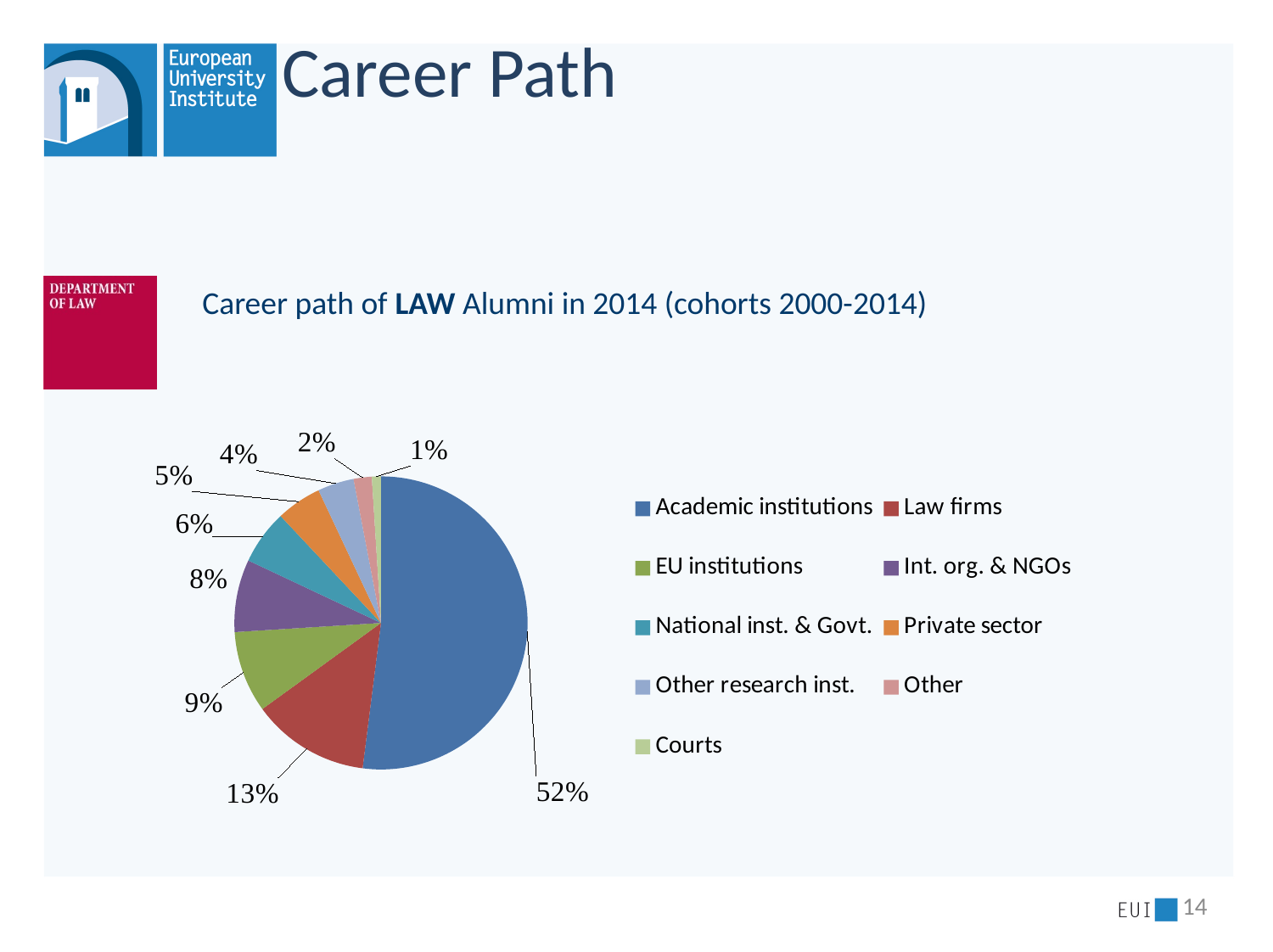
What percentage is shown for Private sector? 5% What is the title of the chart on the slide? Career path of LAW Alumni in 2014 (cohorts 2000-2014) Which category has the largest slice of the pie chart? Academic institutions What percentage of LAW alumni are in Law firms according to the pie chart? 13% What share of the pie chart is EU institutions? 9% Which category has the smallest slice of the pie chart? Courts What percentage is shown for Int. org. & NGOs? 8% What share of the pie chart is Academic institutions? 52% How many categories does the pie chart show? 9 What type of chart is shown on the slide? Pie chart What is the difference in percentage points between Academic institutions and Law firms? 39 Which is larger, the share for National inst. & Govt. or the share for Other research inst.? National inst. & Govt.